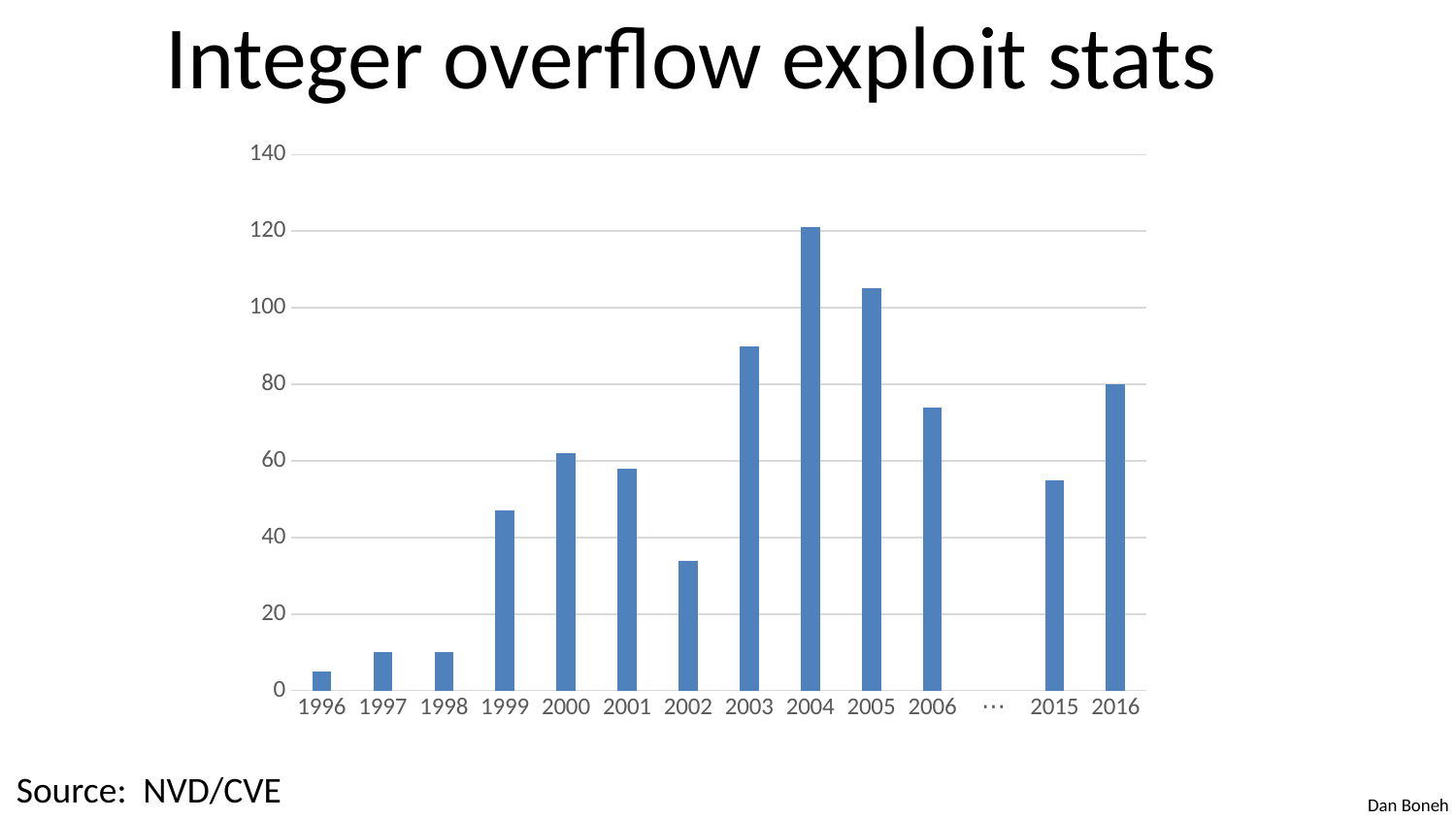
What is the title of the chart? Integer overflow exploit stats Which year has the lowest bar? 1996 Which year has the larger value, 2003 or 2005? 2005 Which year has the larger value, 1999 or 2002? 1999 Which year has the highest bar? 2004 What kind of chart is shown on the slide? bar chart Is the value for 2006 greater or less than 60? greater Is the value for 2002 greater or less than 40? less Is the value for 2015 greater or less than 40? greater Do the values generally rise or fall from 1996 to 2004? rise What source is cited for the chart data? NVD/CVE